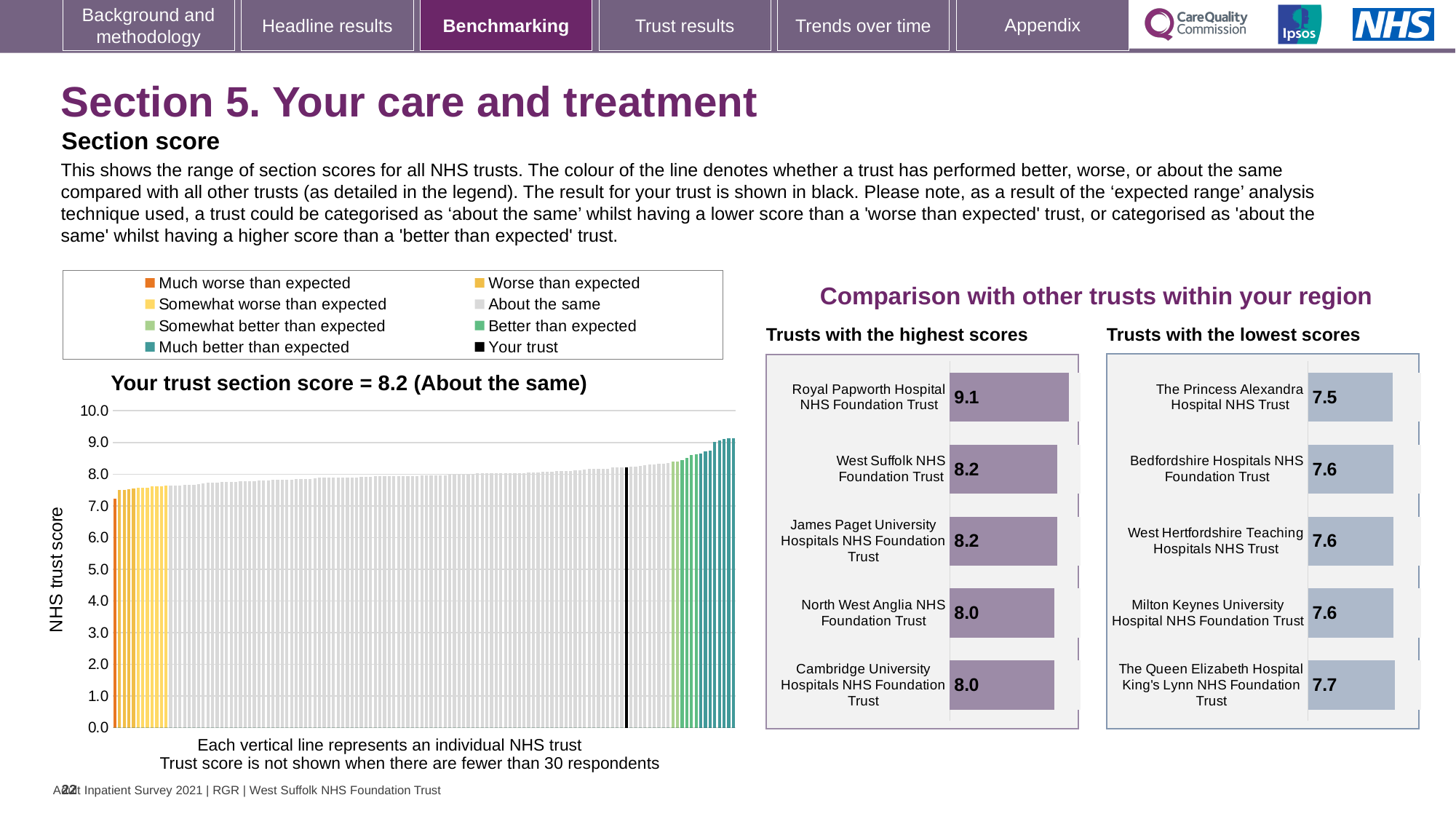
In the main chart on the left, is the value of the leftmost bar greater or less than 8.0? less In the 'Trusts with the lowest scores' chart, which is larger: the score for The Queen Elizabeth Hospital King's Lynn NHS Foundation Trust or The Princess Alexandra Hospital NHS Trust? The Queen Elizabeth Hospital King's Lynn NHS Foundation Trust In the 'Trusts with the highest scores' chart, which trust has the highest score? Royal Papworth Hospital NHS Foundation Trust In the 'Trusts with the highest scores' chart, what is the difference between the scores of Royal Papworth Hospital NHS Foundation Trust and Cambridge University Hospitals NHS Foundation Trust? 1.1 In the 'Trusts with the lowest scores' chart, which trust has the lowest score? The Princess Alexandra Hospital NHS Trust In the 'Trusts with the lowest scores' chart, what is the score for The Queen Elizabeth Hospital King's Lynn NHS Foundation Trust? 7.7 In the 'Trusts with the lowest scores' chart, what is the difference between the scores of The Queen Elizabeth Hospital King's Lynn NHS Foundation Trust and The Princess Alexandra Hospital NHS Trust? 0.2 In the main chart on the left, do the trust scores rise or fall from left to right? rise In the 'Trusts with the lowest scores' chart, what is the score for The Princess Alexandra Hospital NHS Trust? 7.5 In the 'Trusts with the highest scores' chart, what is the score for Royal Papworth Hospital NHS Foundation Trust? 9.1 In the main chart on the left, what is the section score for your trust? 8.2 In the 'Trusts with the highest scores' chart, how many trusts are shown? 5